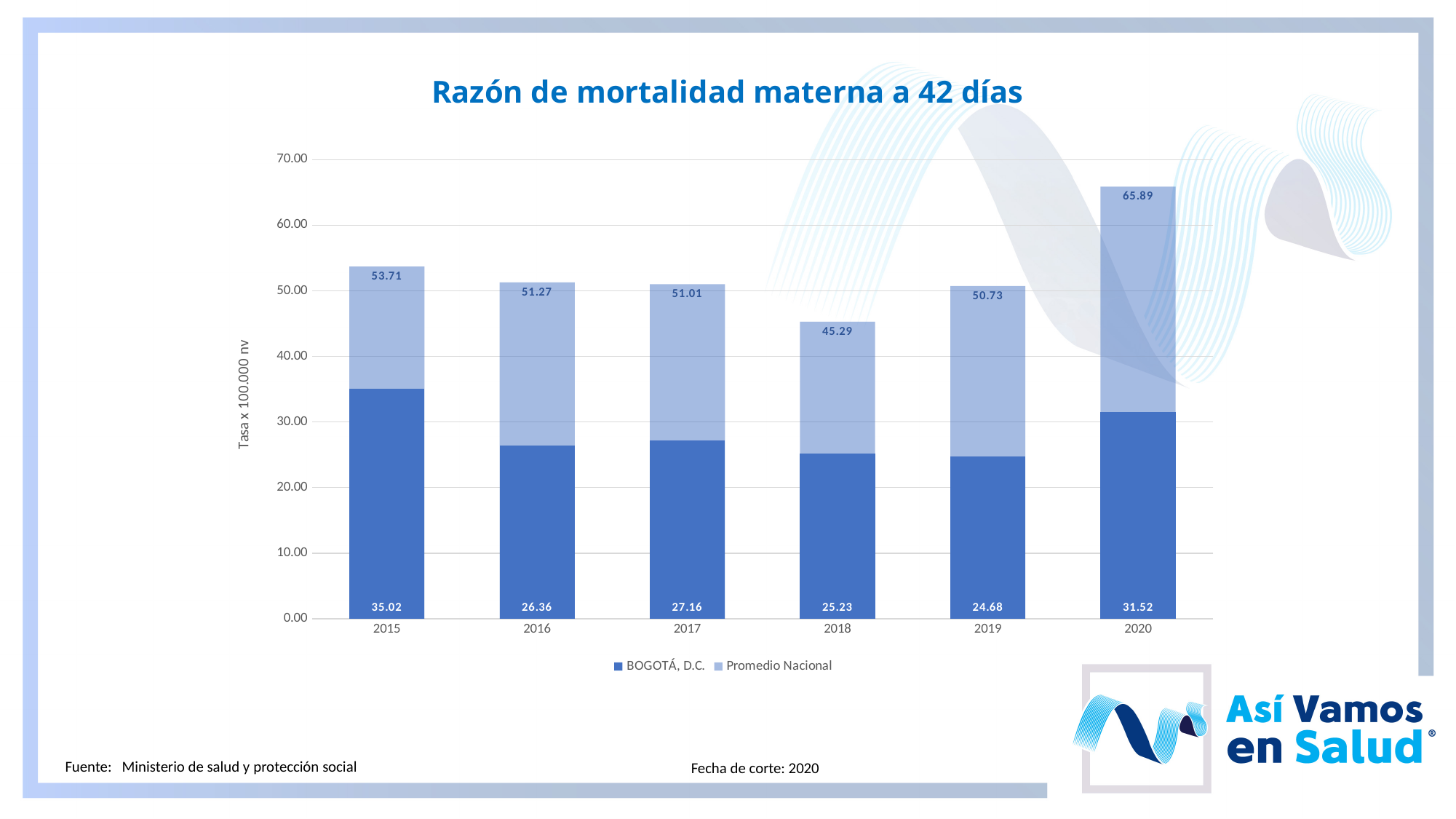
What is the Promedio Nacional value in 2017? 51.01 What is the difference between the Promedio Nacional values in 2020 and 2018? 20.60 What kind of chart is shown on the slide? Bar chart In which year is the BOGOTÁ, D.C. value highest? 2015 In which year is the BOGOTÁ, D.C. value lowest? 2019 In which year is the Promedio Nacional value lowest? 2018 How many series does the legend list? 2 What is the Promedio Nacional value in 2020? 65.89 How many years are shown on the x axis? 6 Which is larger, the BOGOTÁ, D.C. value in 2015 or in 2020? 2015 What is the value for BOGOTÁ, D.C. in 2018? 25.23 What is the value for BOGOTÁ, D.C. in 2015? 35.02